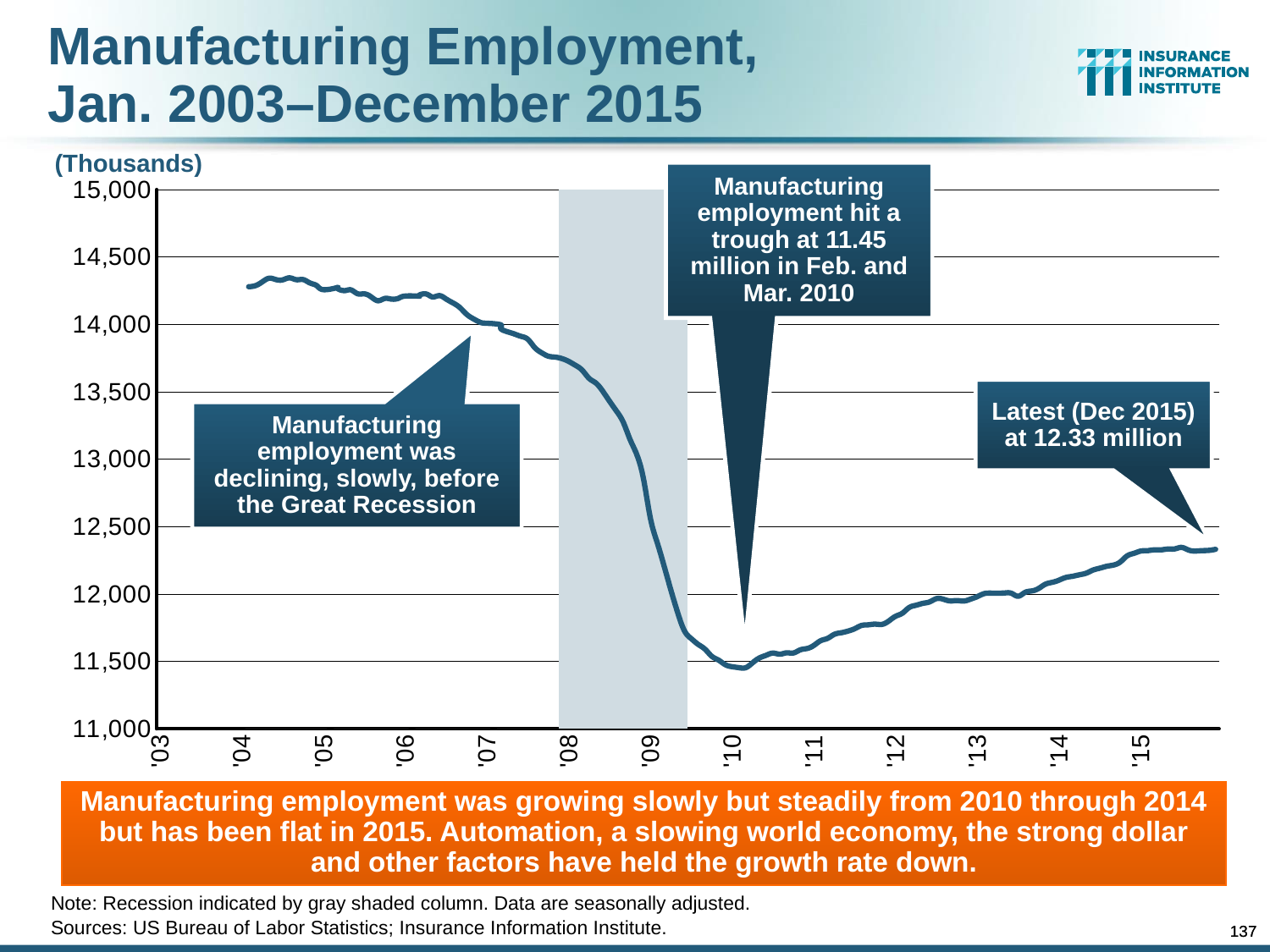
Which is larger, manufacturing employment in 2004 or in 2015? 2004 Is the value for manufacturing employment in 2004 greater or less than 14,000? greater How much higher is the Dec 2015 value (12.33 million) than the trough value (11.45 million)? 0.88 million Is the value for manufacturing employment at the start of 2010 greater or less than 12,000? less Is the value for manufacturing employment in 2015 greater or less than 12,000? greater In which months did manufacturing employment hit its trough, according to the callout? Feb. and Mar. 2010 Did manufacturing employment rise or fall from 2010 through 2014? Rise What kind of chart is shown on the slide? Line chart According to the callout, at what level did manufacturing employment hit its trough? 11.45 million What does the gray shaded column on the chart indicate? Recession In what units are the values on the y-axis expressed? Thousands What was the latest (Dec 2015) manufacturing employment value shown on the chart? 12.33 million